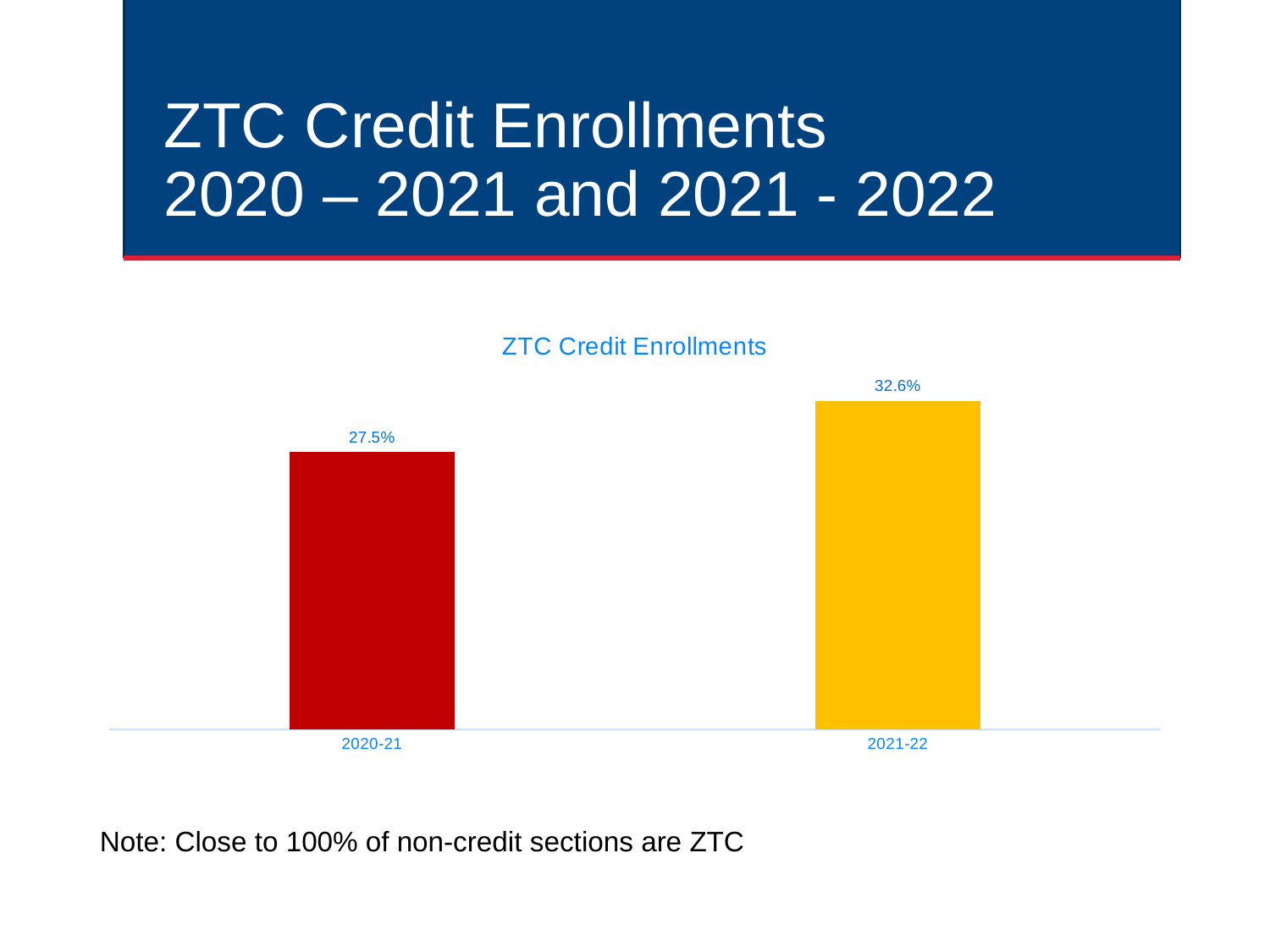
Which year has the highest ZTC credit enrollment percentage? 2021-22 How many categories are shown on the x axis? 2 Which year has the lowest ZTC credit enrollment percentage? 2020-21 What colour is the bar for 2021-22? Yellow What kind of chart is shown on the slide? Bar chart Which is larger, the value for 2020-21 or the value for 2021-22? 2021-22 Do the values rise or fall from 2020-21 to 2021-22? Rise What is the value for 2021-22? 32.6% What is the difference between the values for 2021-22 and 2020-21? 5.1% What is the title of the chart? ZTC Credit Enrollments What is the value for 2020-21? 27.5%